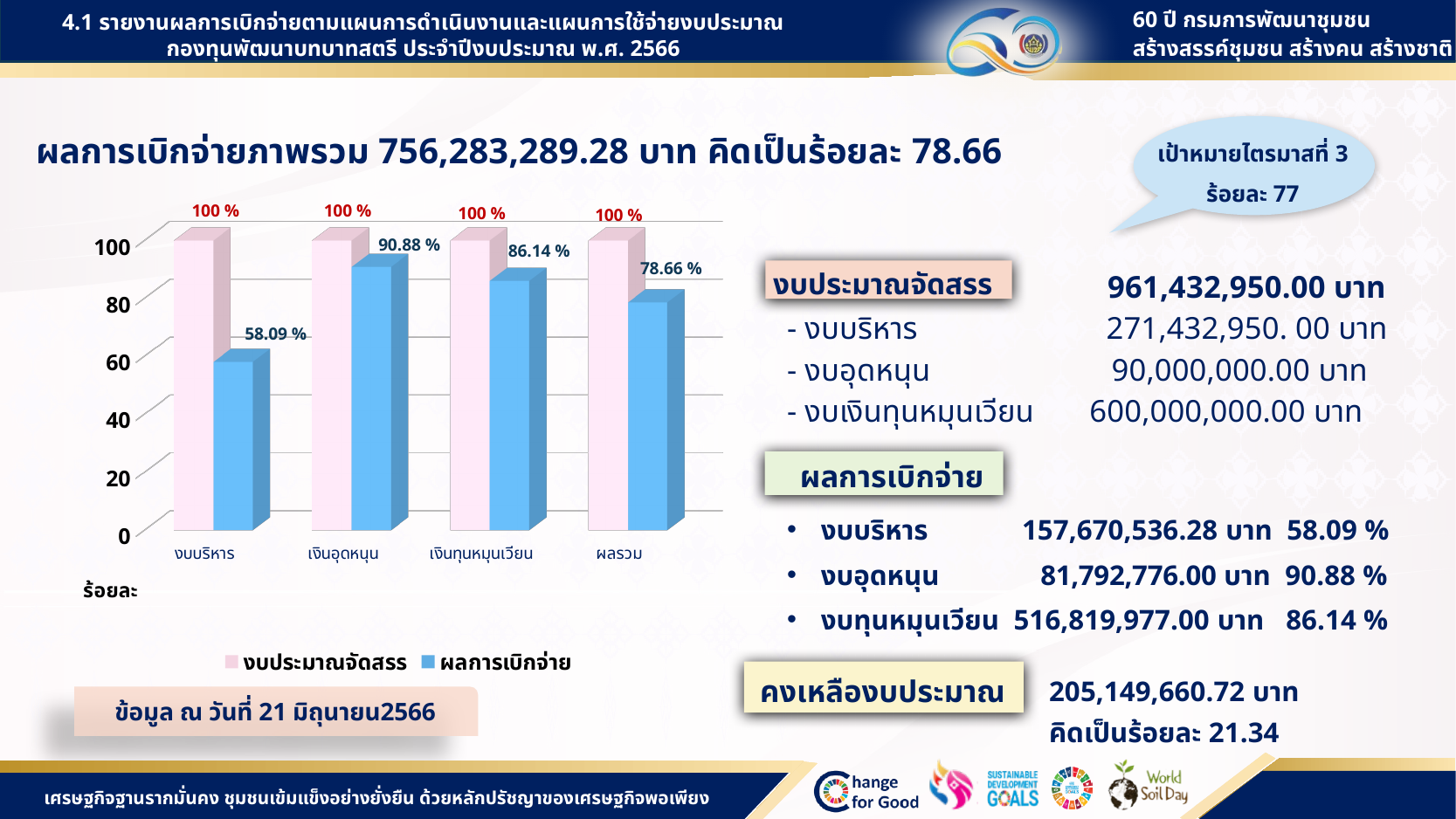
What kind of chart is shown on the slide? Bar chart What is the difference between the ผลการเบิกจ่าย values for เงินอุดหนุน and งบบริหาร? 32.79 % Which is larger, the ผลการเบิกจ่าย value for เงินทุนหมุนเวียน or for ผลรวม? เงินทุนหมุนเวียน Which category has the highest ผลการเบิกจ่าย value? เงินอุดหนุน What is the value of ผลการเบิกจ่าย for งบบริหาร? 58.09 % What is the value of ผลการเบิกจ่าย for เงินอุดหนุน? 90.88 % Which category has the lowest ผลการเบิกจ่าย value? งบบริหาร What is the value of ผลการเบิกจ่าย for เงินทุนหมุนเวียน? 86.14 % What is the value of ผลการเบิกจ่าย for ผลรวม? 78.66 % How many categories are shown on the x axis of the chart? 4 How many series does the chart legend list? 2 What is the value of งบประมาณจัดสรร for เงินอุดหนุน? 100 %